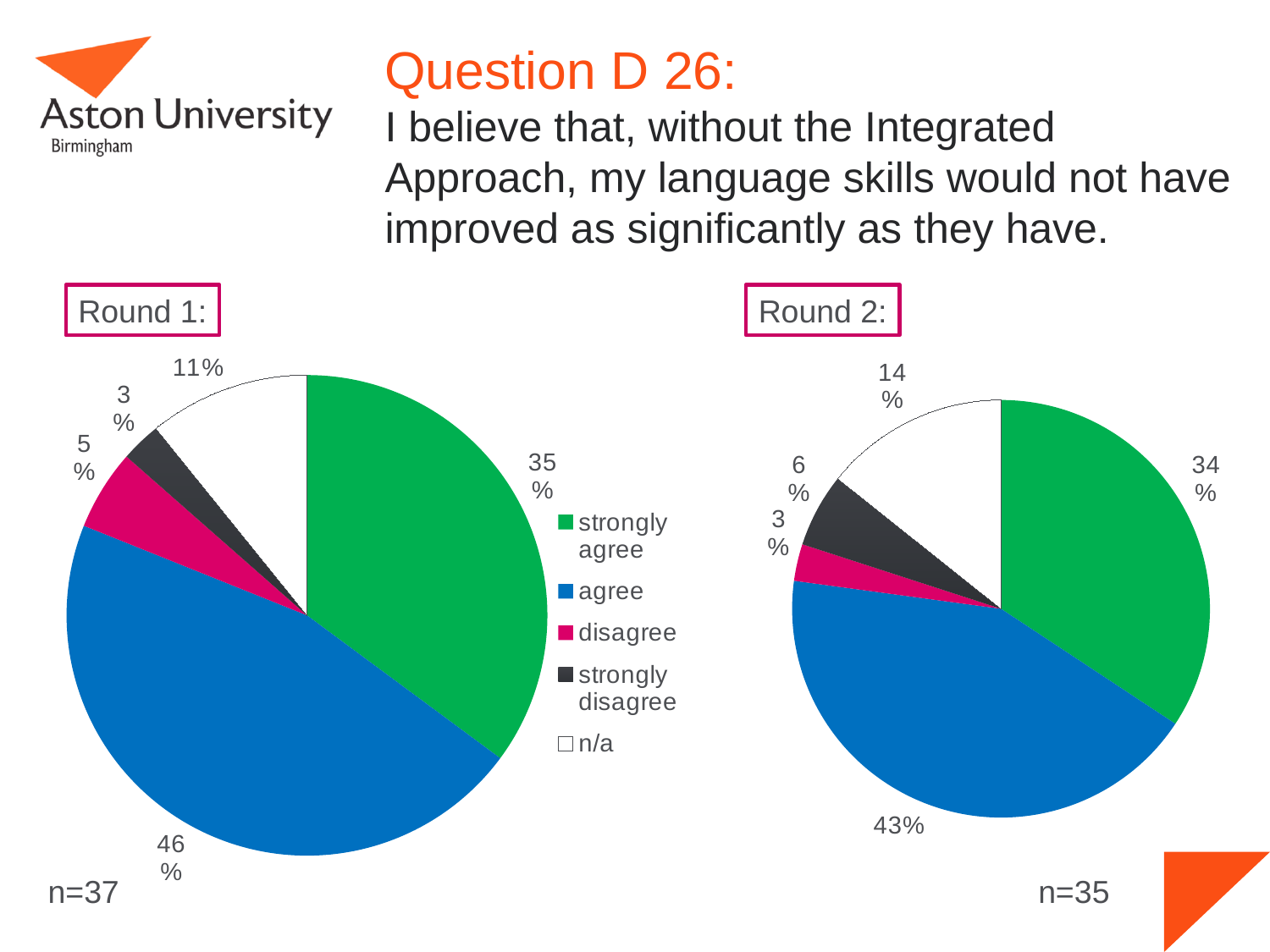
Which is larger: the 'n/a' share in the Round 1 pie chart or in the Round 2 pie chart? Round 2 In the Round 1 pie chart, what percentage is shown for 'n/a'? 11% How many entries does the legend list? 5 In the Round 2 pie chart, what percentage is shown for 'strongly disagree'? 6% In the Round 1 pie chart, which category has the largest slice? agree In the Round 2 pie chart, which category has the smallest slice? disagree What is the difference between the 'agree' percentages in the Round 1 and Round 2 pie charts? 3% How many slices does the Round 2 pie chart have? 5 In the Round 2 pie chart, what percentage is shown for 'strongly agree'? 34% In the Round 1 pie chart, what percentage is shown for 'agree'? 46% In the Round 1 pie chart, which category has the smallest slice? strongly disagree What type of chart is used for Round 1 and Round 2? pie chart